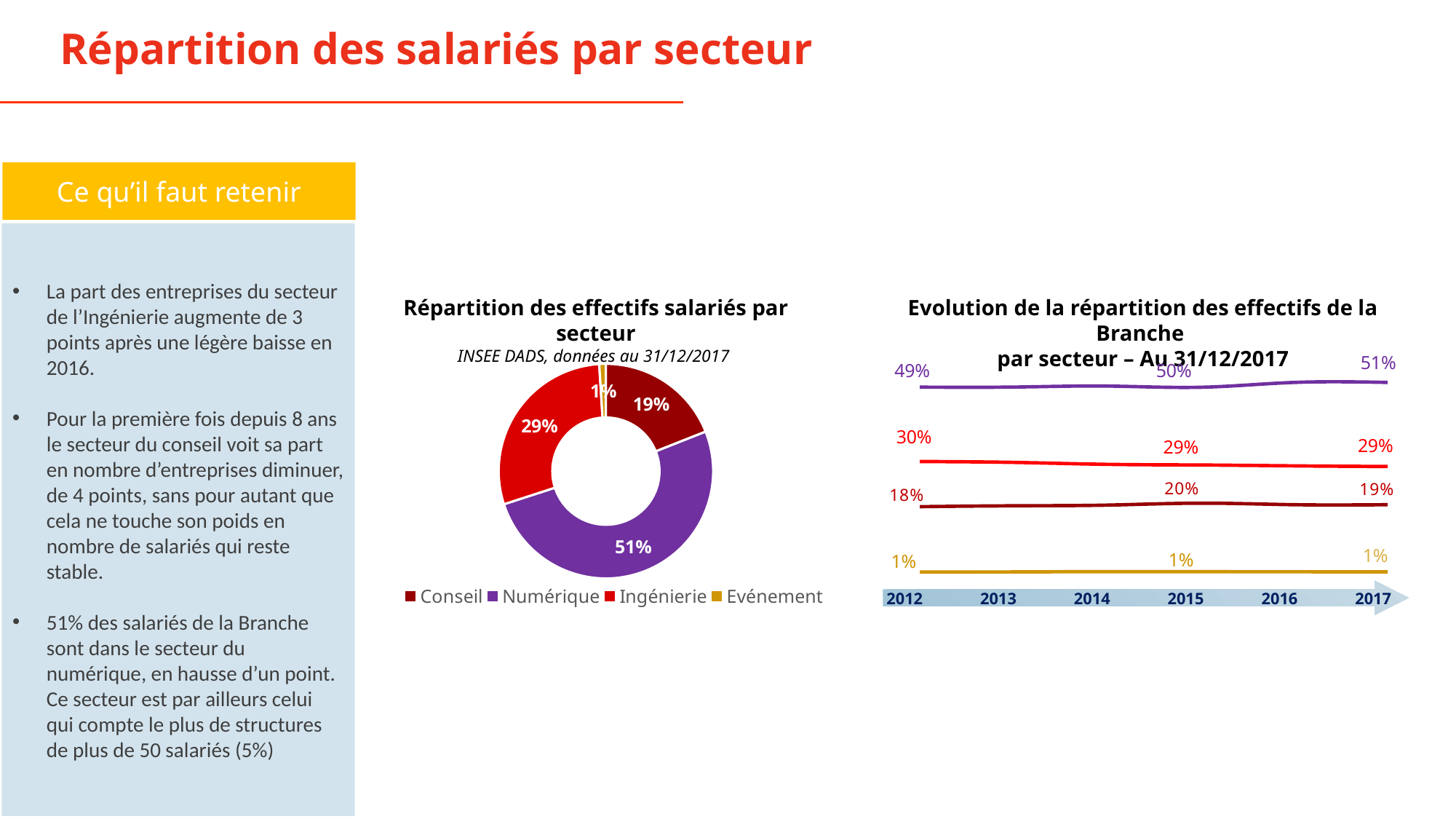
In the line chart 'Evolution de la répartition des effectifs de la Branche par secteur', what is the value of the dark red line in 2015? 20% How many sectors does the legend of the donut chart 'Répartition des effectifs salariés par secteur' list? 4 In the line chart 'Evolution de la répartition des effectifs de la Branche par secteur', does the purple line rise or fall from 2012 to 2017? Rises In the line chart 'Evolution de la répartition des effectifs de la Branche par secteur', what is the value of the purple line in 2012? 49% In the donut chart 'Répartition des effectifs salariés par secteur', what is the value for Conseil? 19% In the donut chart 'Répartition des effectifs salariés par secteur', what share of employees is in the Numérique sector? 51% In the donut chart 'Répartition des effectifs salariés par secteur', which sector has the largest share? Numérique In the donut chart 'Répartition des effectifs salariés par secteur', what is the difference in percentage points between Numérique and Ingénierie? 22 In the line chart 'Evolution de la répartition des effectifs de la Branche par secteur', how many years are shown on the x axis? 6 What type of chart is 'Répartition des effectifs salariés par secteur'? Donut (pie) chart In the donut chart 'Répartition des effectifs salariés par secteur', what is the value for Ingénierie? 29% In the donut chart 'Répartition des effectifs salariés par secteur', which sector has the smallest share? Evénement